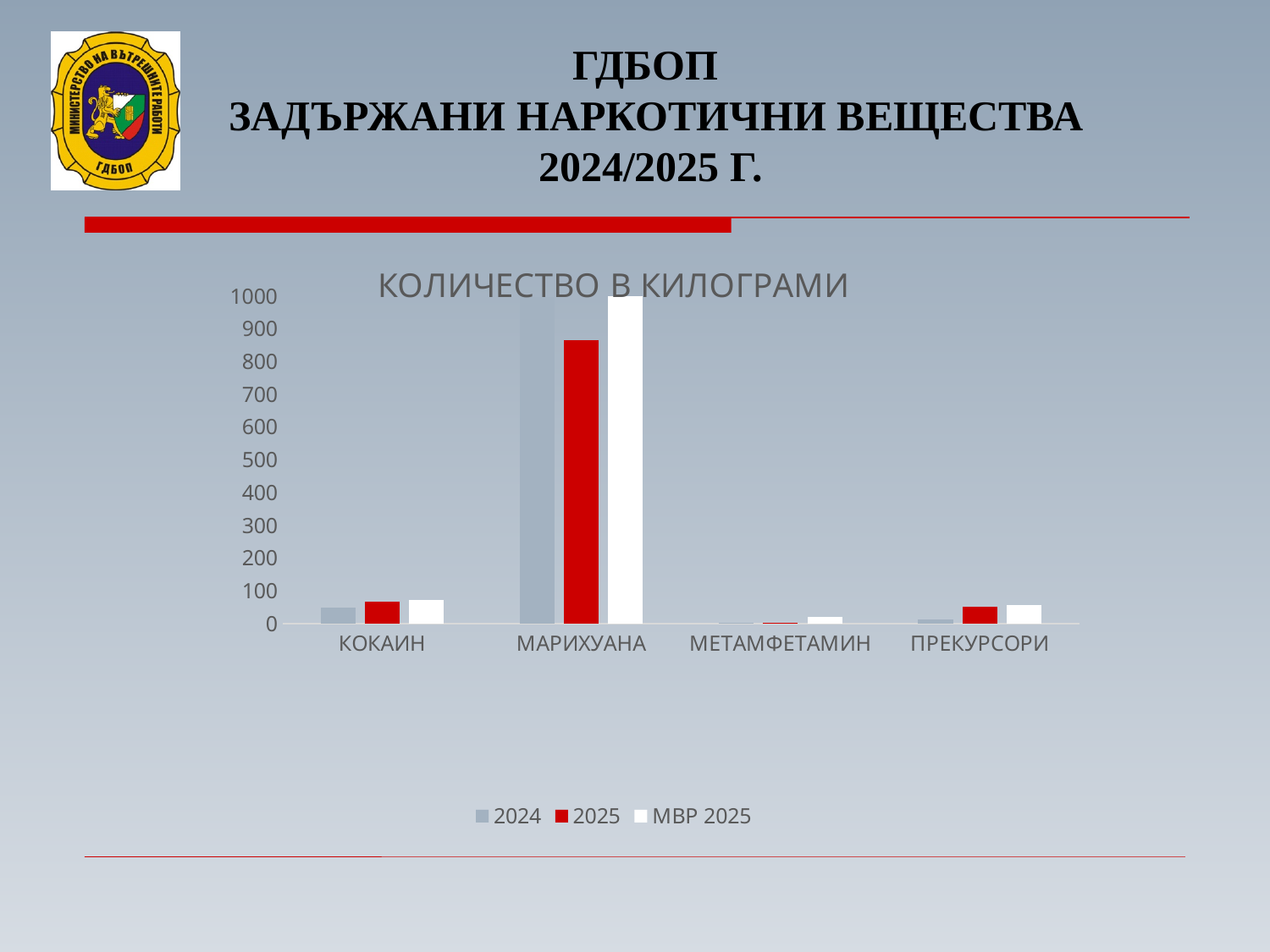
What is the title of the chart? КОЛИЧЕСТВО В КИЛОГРАМИ How many series does the chart's legend list? 3 What kind of chart is shown on the slide? bar chart Which category has the highest values in the chart? МАРИХУАНА How many categories are shown on the x axis of the chart? 4 Is the МВР 2025 value for МАРИХУАНА greater or less than 900? greater Is the 2025 value for МАРИХУАНА greater or less than 800? greater Which category has the lowest values in the chart? МЕТАМФЕТАМИН Which series is shown in red in the chart? 2025 Is the 2025 value for КОКАИН greater or less than 100? less Which is larger, the 2025 value for МАРИХУАНА or the 2025 value for КОКАИН? МАРИХУАНА